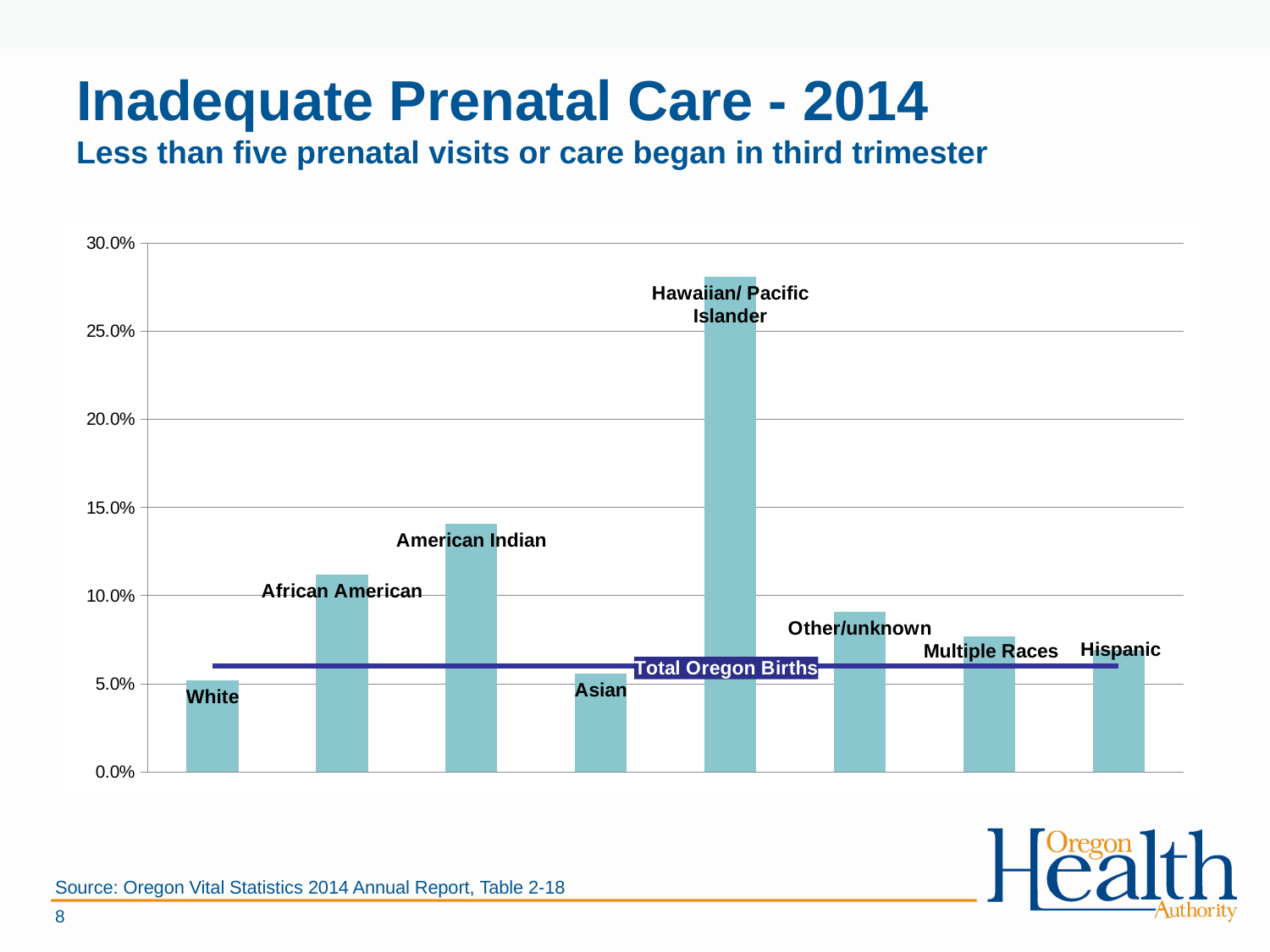
Which has a higher rate of inadequate prenatal care, American Indian or African American? American Indian What does the horizontal line across the chart represent? Total Oregon Births Is the value for Other/unknown greater or less than 10.0%? less Is the value for African American greater or less than 10.0%? greater Is the value for White greater or less than 10.0%? less What kind of chart is shown on the slide? Bar chart How many racial/ethnic group bars are plotted in the chart? 8 Which has a higher rate of inadequate prenatal care, Other/unknown or Hispanic? Other/unknown What is the title of the slide containing the chart? Inadequate Prenatal Care - 2014 Which racial/ethnic group has the highest rate of inadequate prenatal care? Hawaiian/ Pacific Islander